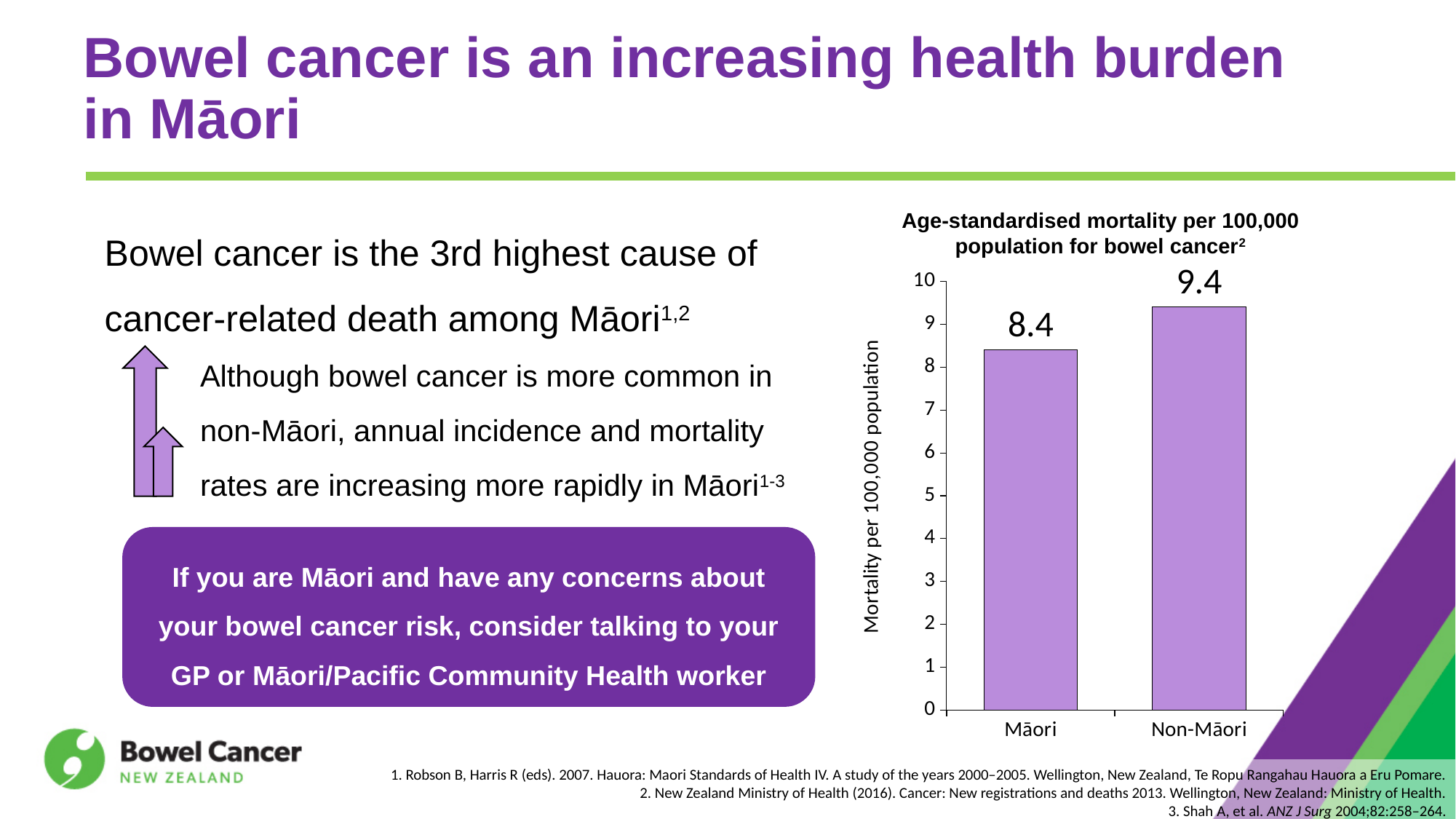
Is the mortality rate for Non-Māori greater or less than 9? greater What is the age-standardised mortality per 100,000 population for bowel cancer for Non-Māori? 9.4 How many categories are shown on the x axis of the chart? 2 What kind of chart is shown on the slide? bar chart What is the maximum value shown on the y axis of the chart? 10 What is the age-standardised mortality per 100,000 population for bowel cancer for Māori? 8.4 What is the label of the y axis of the chart? Mortality per 100,000 population Which group has the higher bowel cancer mortality rate in the chart? Non-Māori What is the difference between the Non-Māori and Māori mortality rates shown in the chart? 1.0 Which group has the lower bowel cancer mortality rate in the chart? Māori Is the mortality rate for Māori greater or less than 9? less